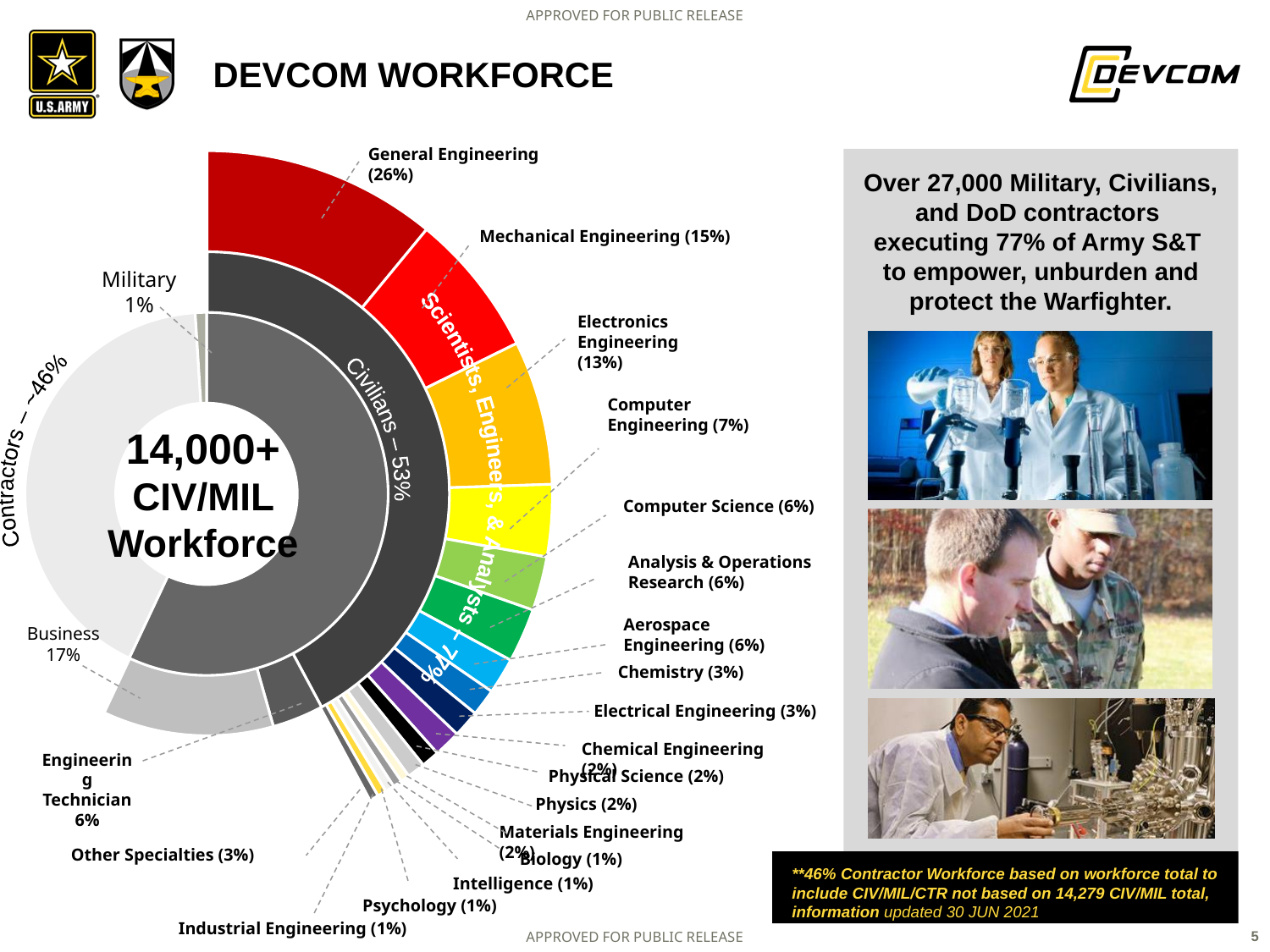
What percentage of the workforce is General Engineering? 26% What is the difference in percentage points between Business and Engineering Technician? 11 What kind of chart is shown on the slide? Donut chart Which is larger, Computer Engineering or Computer Science? Computer Engineering What percentage of the workforce is Military? 1% What percentage of the workforce is Mechanical Engineering? 15% What percentage of the workforce is Electronics Engineering? 13% What is the difference in percentage points between General Engineering and Mechanical Engineering? 11 What percentage of the workforce is Civilians? 53% What text is shown in the center of the chart? 14,000+ CIV/MIL Workforce Which engineering or science specialty in the outer ring has the largest share? General Engineering What percentage of the workforce is Business? 17%